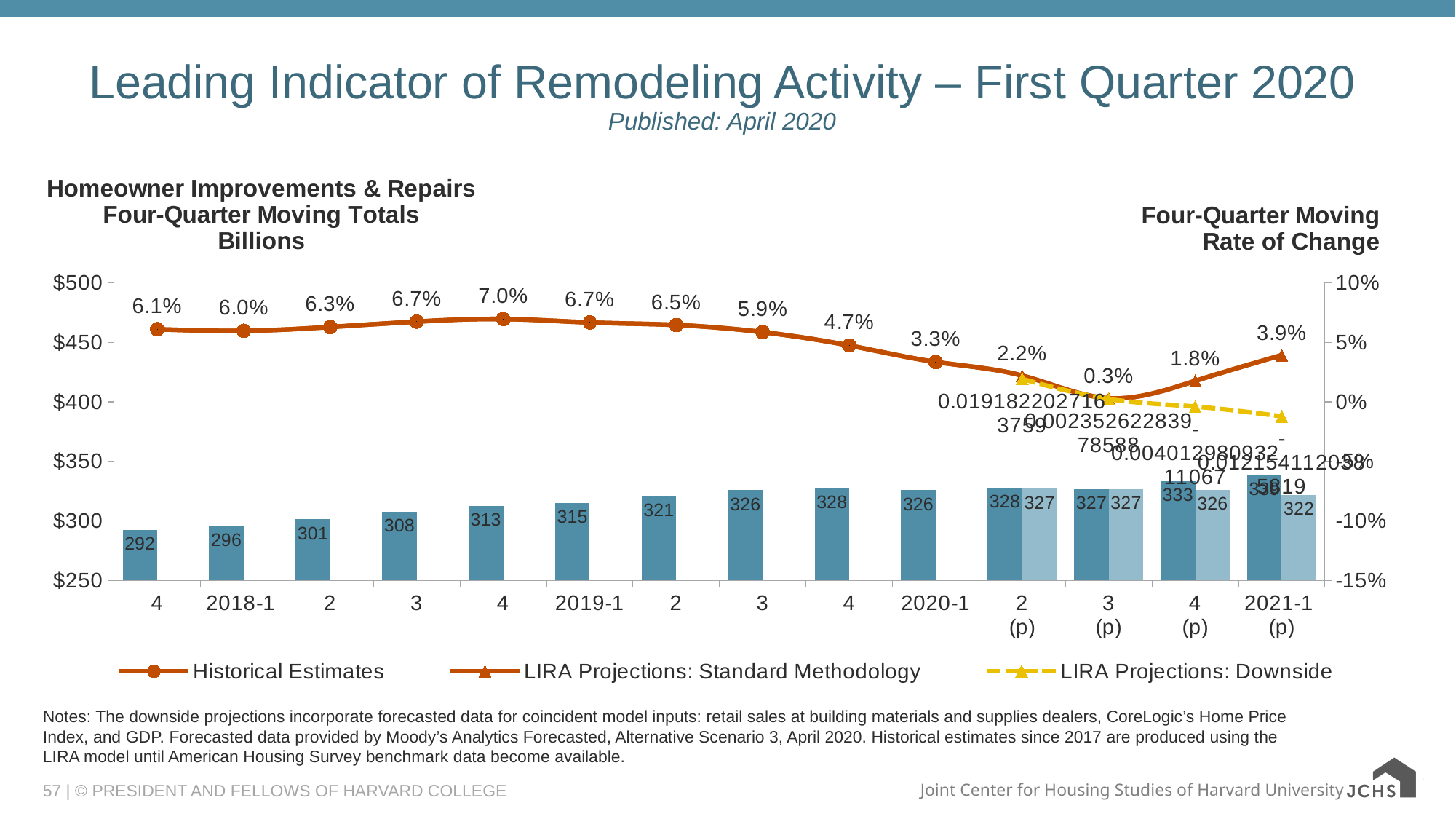
What is the Historical Estimates rate of change for 2018-1? 6.0% Is the four-quarter moving total for 2018-1 greater or less than $300? less What is the difference between the four-quarter moving totals for 2019-1 and 2018-1? 19 How many series does the legend list? 3 What is the highest Historical Estimates rate of change shown on the chart? 7.0% What is the lowest four-quarter moving total shown by the bars? 292 What is the four-quarter moving total (in billions) shown for 2019-1? 315 Which has the larger four-quarter moving total: the third quarter of 2019 or the fourth quarter of 2019? Fourth quarter of 2019 What kind of chart is this? Combination bar and line chart Does the Historical Estimates rate of change rise or fall from 2019-1 to 2020-1? Fall How many quarters are shown along the x axis? 14 What is the LIRA Projections: Standard Methodology rate of change for 2021-1 (p)? 3.9%